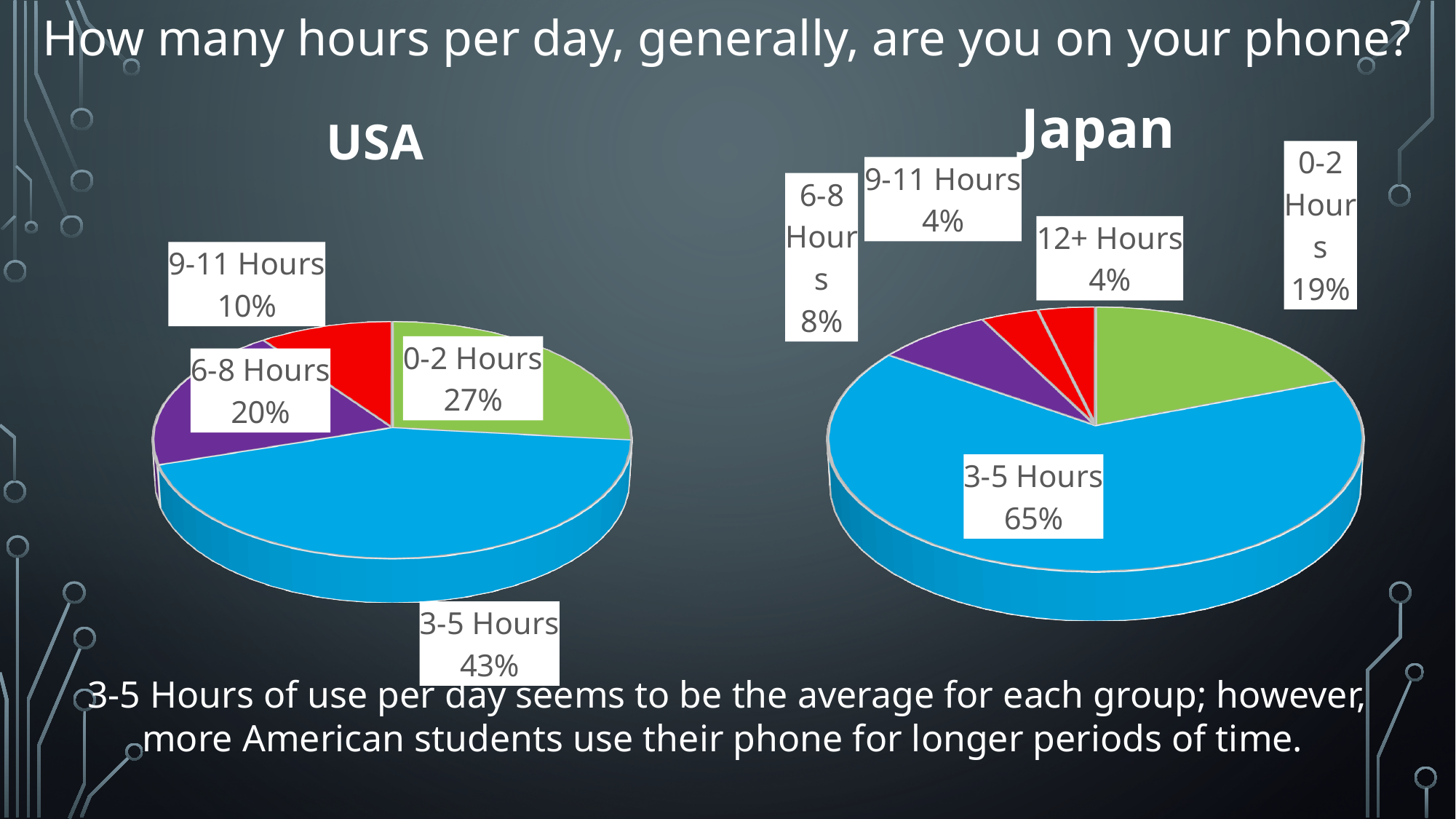
What type of chart is used for the USA data? Pie chart In the Japan pie chart, which category has the largest share? 3-5 Hours In the USA pie chart, what is the difference between the 0-2 Hours share and the 6-8 Hours share? 7% In the Japan pie chart, what share of respondents are on their phone 12+ hours per day? 4% In the USA pie chart, which category has the smallest share? 9-11 Hours In the Japan pie chart, what is the difference between the 3-5 Hours share and the 0-2 Hours share? 46% In the Japan pie chart, what share of respondents are on their phone 0-2 hours per day? 19% Which is larger: the 6-8 Hours share in the USA chart or the 6-8 Hours share in the Japan chart? USA In the USA pie chart, what share of respondents are on their phone 3-5 hours per day? 43% In the USA pie chart, which category has the largest share? 3-5 Hours How many categories are shown in the Japan pie chart? 5 How many categories are shown in the USA pie chart? 4